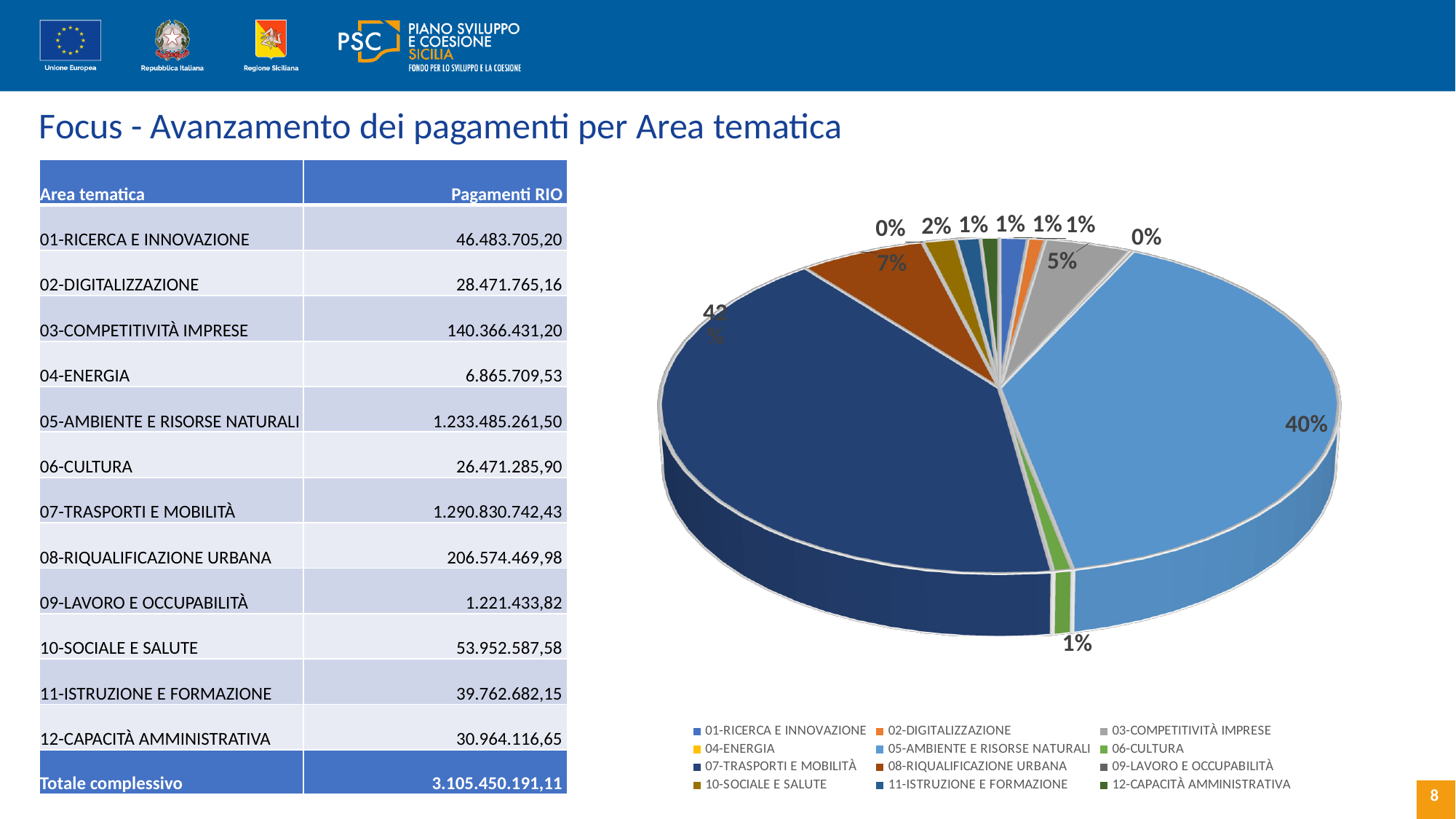
What percentage is shown for 10-SOCIALE E SALUTE? 2% What percentage is shown for 03-COMPETITIVITÀ IMPRESE? 5% What kind of chart is shown on the slide? Pie chart What share of the pie does 07-TRASPORTI E MOBILITÀ represent? 42% How many categories does the pie chart legend list? 12 What percentage is shown for 08-RIQUALIFICAZIONE URBANA? 7% What percentage is shown for 04-ENERGIA? 0% What share of the pie does 05-AMBIENTE E RISORSE NATURALI represent? 40% What colour is the slice for 08-RIQUALIFICAZIONE URBANA? Brown/orange Which area tematica has the largest slice of the pie? 07-TRASPORTI E MOBILITÀ What is the difference in percentage points between the 07-TRASPORTI E MOBILITÀ slice and the 05-AMBIENTE E RISORSE NATURALI slice? 2 percentage points Which is larger, the slice for 05-AMBIENTE E RISORSE NATURALI or the slice for 07-TRASPORTI E MOBILITÀ? 07-TRASPORTI E MOBILITÀ